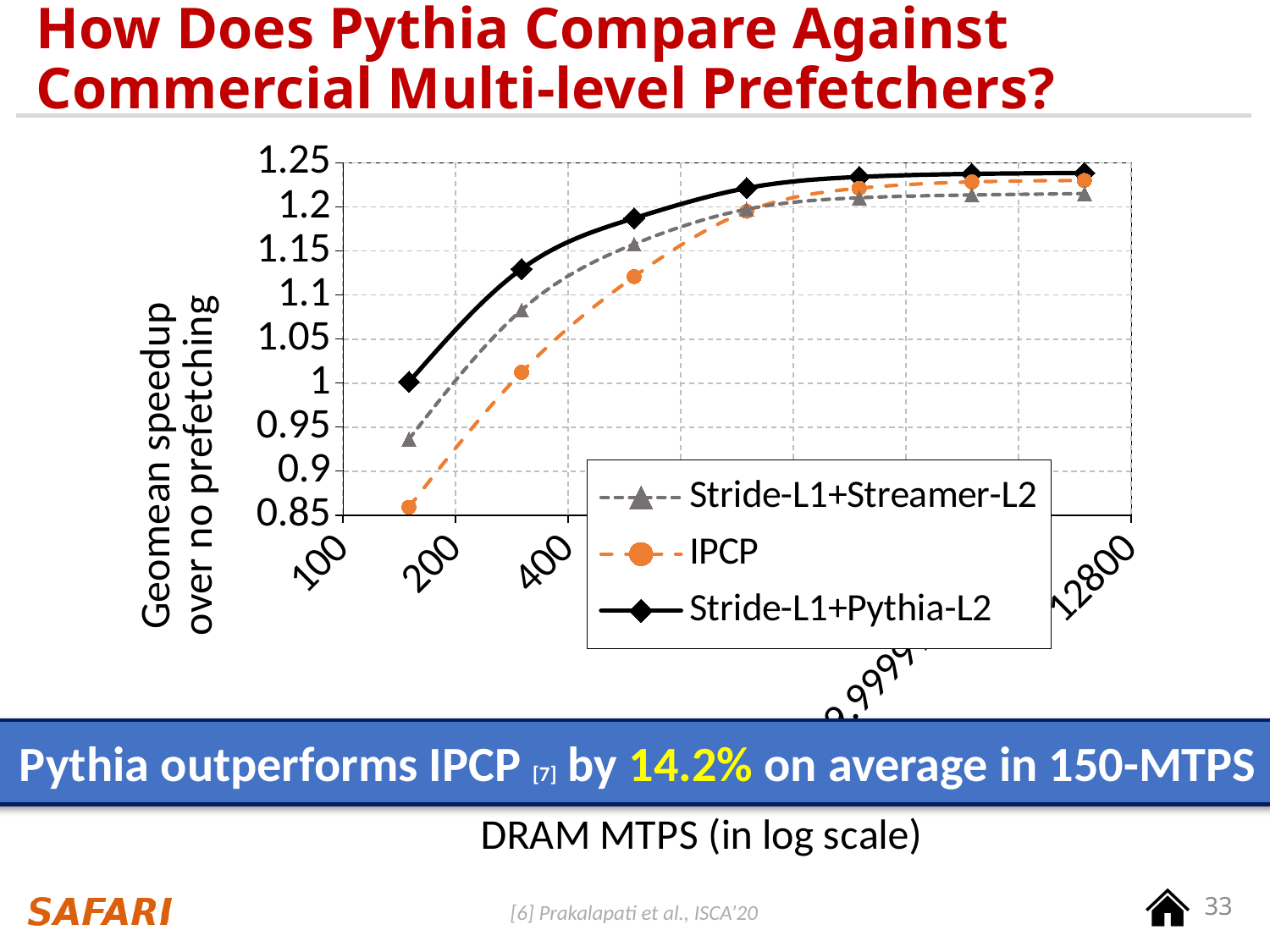
Do the values of the Stride-L1+Pythia-L2 series rise or fall as DRAM MTPS increases? rise At the lowest DRAM MTPS plotted, which series has the lowest speedup? IPCP How many series does the chart's legend list? 3 At the lowest DRAM MTPS plotted, which series has the higher speedup: Stride-L1+Pythia-L2 or IPCP? Stride-L1+Pythia-L2 Do the values of the IPCP series rise or fall as DRAM MTPS increases? rise Is the leftmost value of the Stride-L1+Streamer-L2 series greater or less than 1? less What kind of chart is shown on the slide? line chart Which series are listed in the chart's legend? Stride-L1+Streamer-L2, IPCP, Stride-L1+Pythia-L2 What is the label of the chart's y axis? Geomean speedup over no prefetching Is the leftmost value of the IPCP series greater or less than 0.9? less